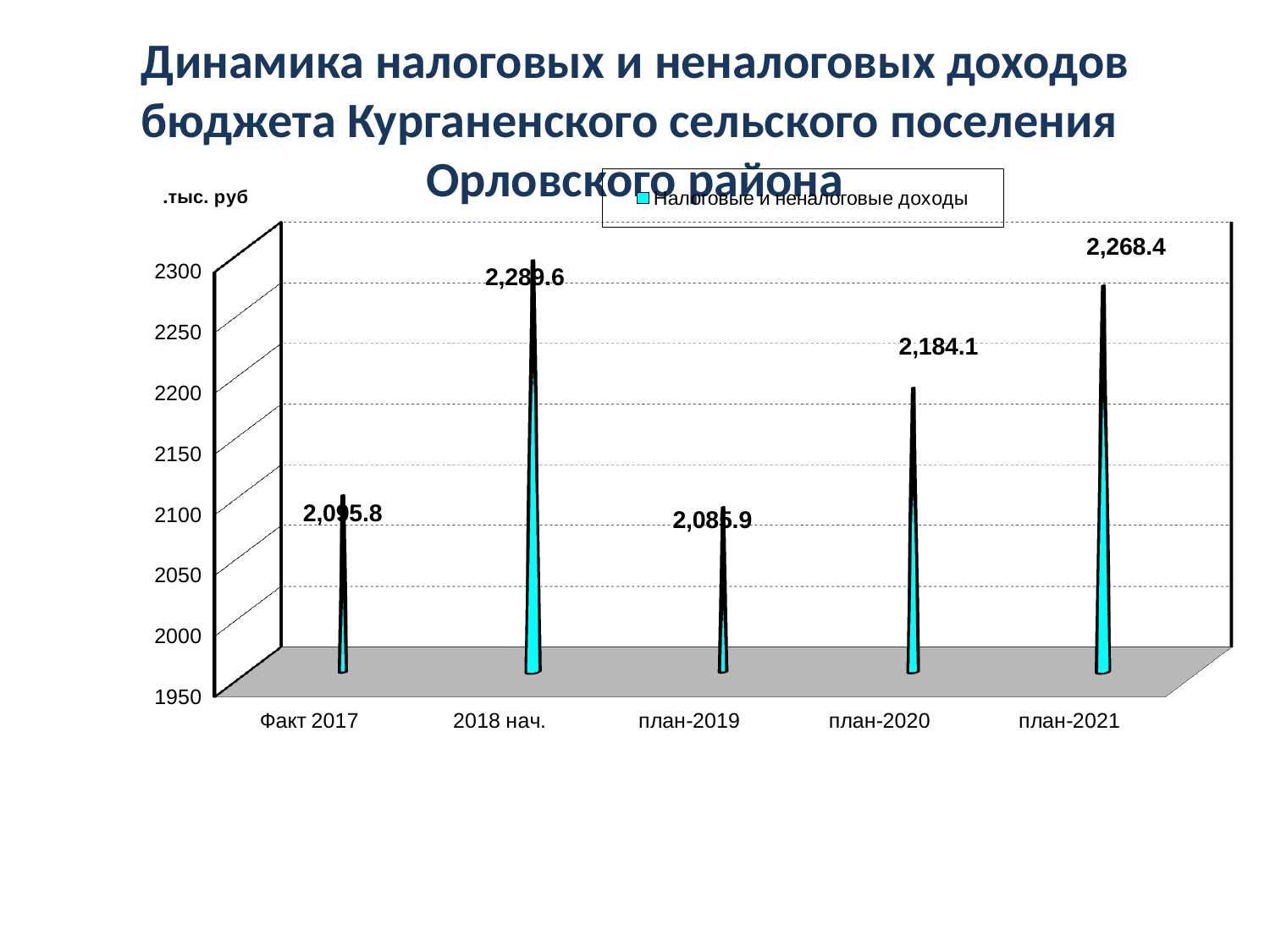
What is the value for план-2021? 2,268.4 How many categories are shown on the x axis? 5 How many series does the legend list? 1 What is the value for план-2020? 2,184.1 Which is larger, the value for план-2020 or the value for план-2021? план-2021 Is the value for план-2020 greater or less than 2150? greater What is the difference between the values for план-2021 and план-2020? 84.3 What is the value for Факт 2017? 2,095.8 Which category has the highest value? 2018 нач. What is the value for 2018 нач.? 2,289.6 What unit is shown on the vertical axis label? тыс. руб Which category has the lowest value? план-2019